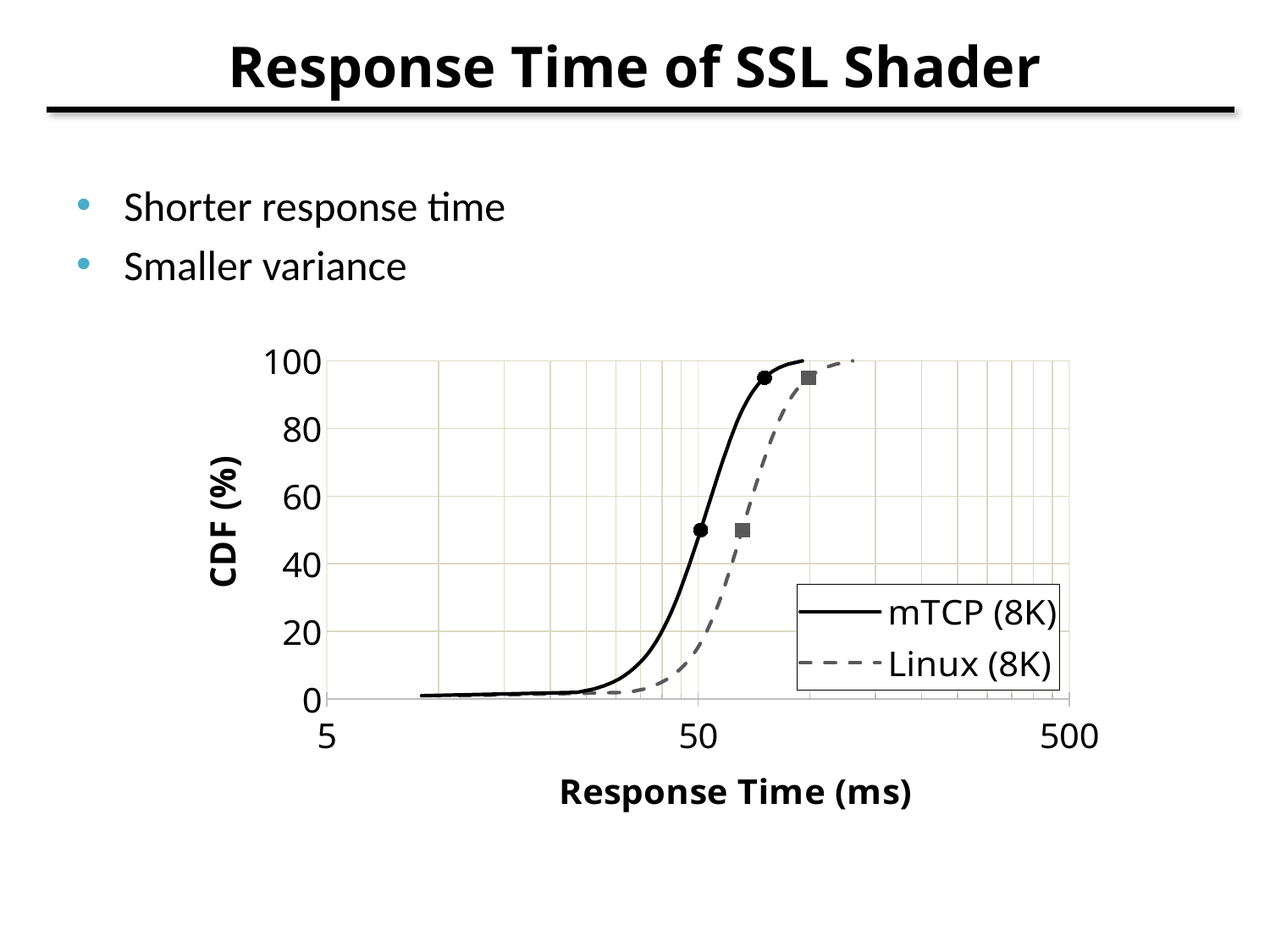
What kind of chart is shown on the slide? line chart What is the highest value shown on the y axis? 100 What are the two series named in the legend? mTCP (8K) and Linux (8K) Which series is drawn with a dashed line? Linux (8K) Do the CDF values for mTCP (8K) rise or fall as response time increases along the x axis? rise Which series reaches 50% CDF at a shorter response time, mTCP (8K) or Linux (8K)? mTCP (8K) Is the CDF value for Linux (8K) at a response time of 50 ms greater or less than 20? less Is the CDF value for mTCP (8K) at a response time of 50 ms greater or less than 40? greater Which series reaches 95% CDF at a longer response time, mTCP (8K) or Linux (8K)? Linux (8K) How many series does the legend list? 2